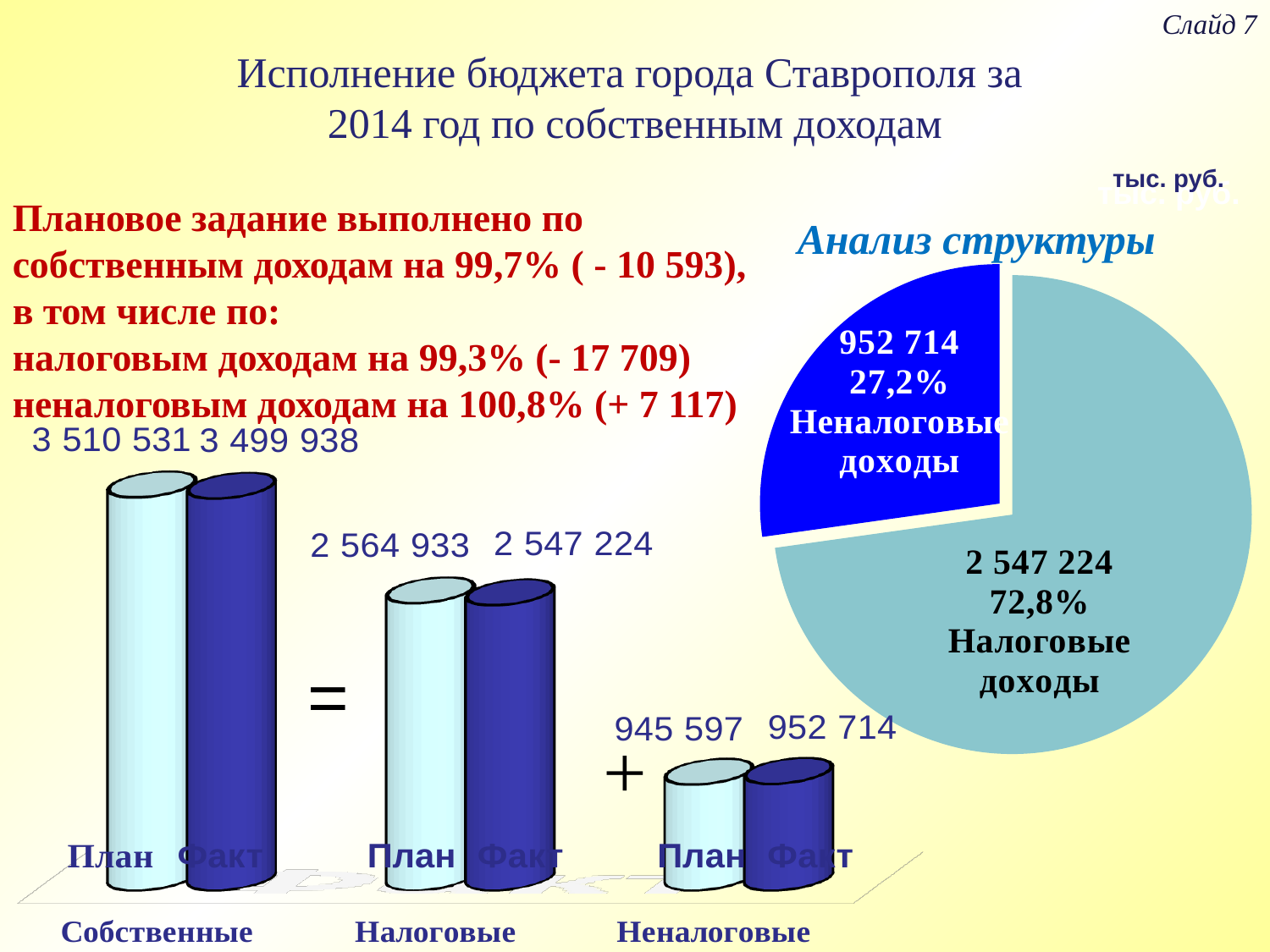
In the bar chart, what is the difference between the План and Факт values for Налоговые? 17 709 In the bar chart, what is the План (plan) value for Собственные? 3 510 531 What is the title of the pie chart on the right of the slide? Анализ структуры In the bar chart, which category has the lowest values? Неналоговые What type of chart is the chart on the left of the slide? bar chart In the bar chart, for Неналоговые, which is larger: План or Факт? Факт How many categories are shown in the bar chart? 3 In the pie chart 'Анализ структуры', what share do Налоговые доходы have? 72,8% In the bar chart, what is the difference between the План and Факт values for Собственные? 10 593 In the pie chart 'Анализ структуры', what is the value for Неналоговые доходы? 952 714 In the bar chart, what is the План value for Неналоговые? 945 597 In the bar chart, what is the Факт (actual) value for Налоговые? 2 547 224